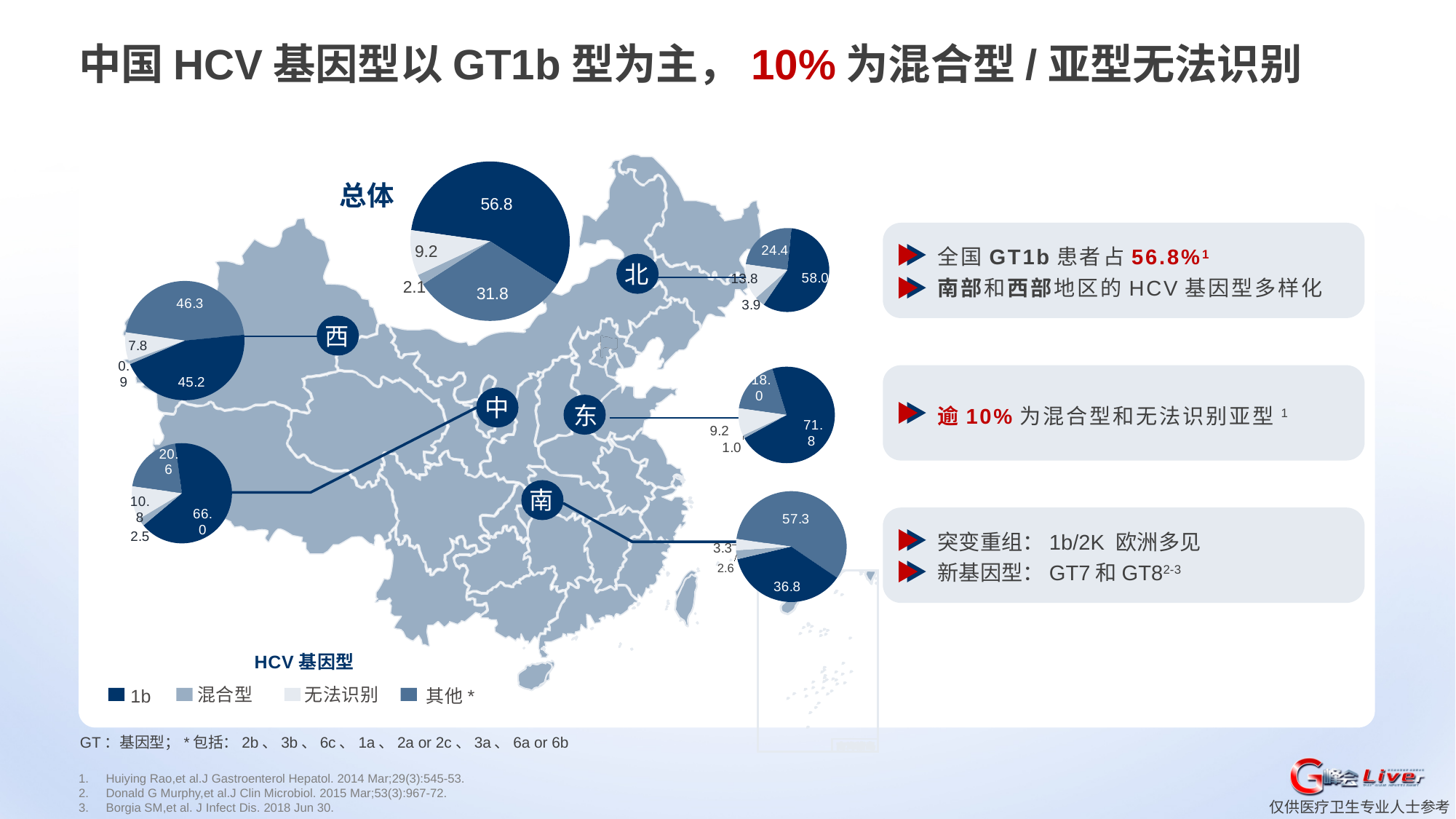
In the 西 pie chart, what is the smallest value shown? 0.9 In the 总体 pie chart, what is the value of the 1b slice? 56.8 In the 南 pie chart, what is the largest value shown? 57.3 In the 总体 pie chart, what is the difference between the 56.8 slice and the 31.8 slice? 25.0 In the 东 pie chart, what is the largest value shown? 71.8 Which pie chart has the larger largest slice, 东 or 中? 东 In the 总体 pie chart, what is the smallest value shown? 2.1 How many genotype categories does the HCV 基因型 legend list? 4 How many pie charts are shown on the slide? 6 What is the title of the legend below the map? HCV 基因型 In the 北 pie chart, what is the largest value shown? 58.0 What kind of charts are shown on the map of China? Pie charts